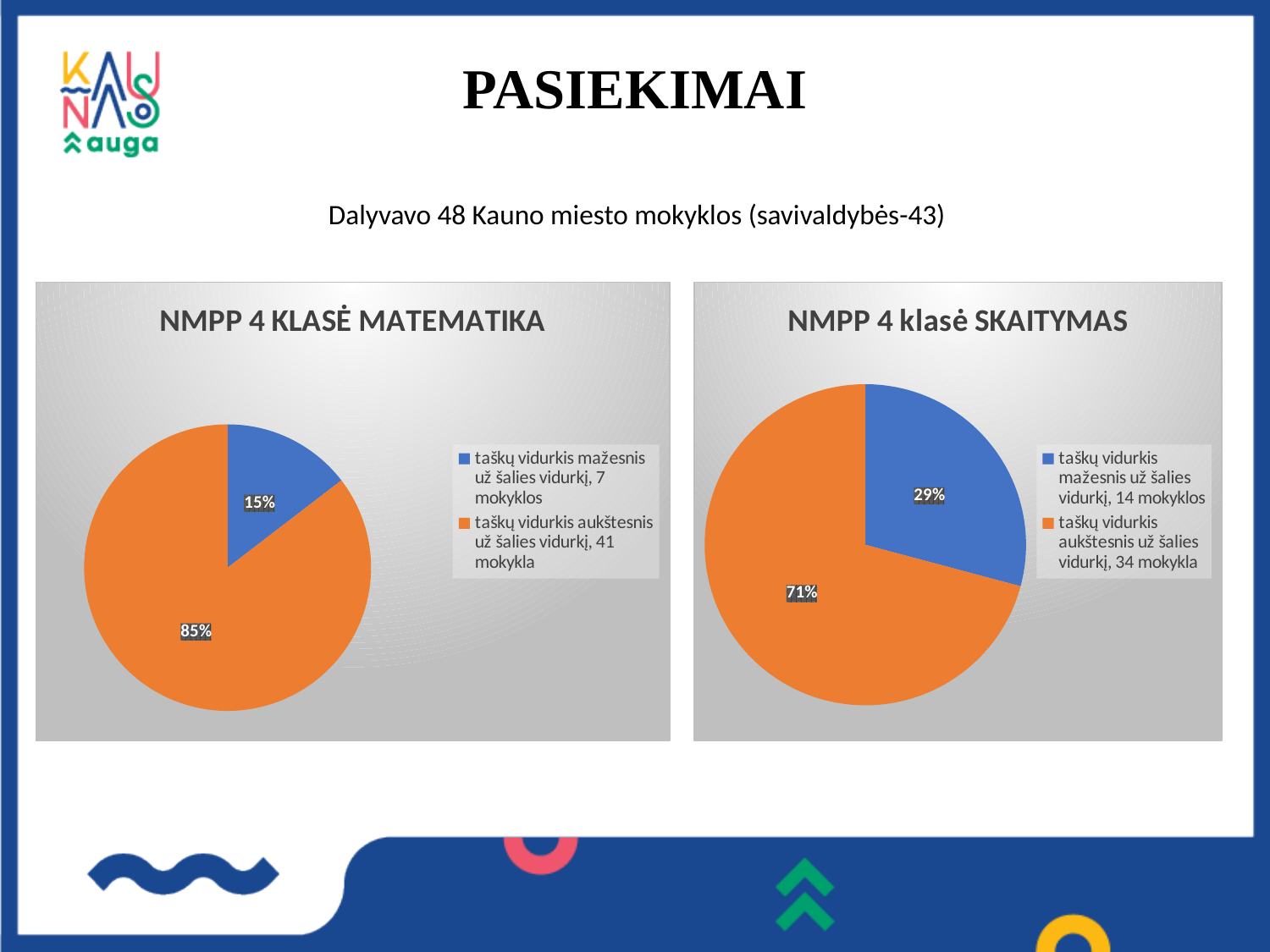
In the 'NMPP 4 KLASĖ MATEMATIKA' chart, what percentage of schools had an average score higher than the national average? 85% In the 'NMPP 4 klasė SKAITYMAS' chart, what is the difference in percentage points between the two slices? 42 In the 'NMPP 4 klasė SKAITYMAS' chart, how many schools does the legend say had an average score lower than the national average? 14 In the 'NMPP 4 klasė SKAITYMAS' chart, which slice is the largest? taškų vidurkis aukštesnis už šalies vidurkį, 34 mokykla In the 'NMPP 4 klasė SKAITYMAS' chart, what percentage of schools had an average score higher than the national average? 71% What type of chart is 'NMPP 4 KLASĖ MATEMATIKA'? Pie chart In the 'NMPP 4 KLASĖ MATEMATIKA' chart, which slice is the smallest? taškų vidurkis mažesnis už šalies vidurkį, 7 mokyklos In the 'NMPP 4 KLASĖ MATEMATIKA' chart, what percentage of schools had an average score lower than the national average? 15% In the 'NMPP 4 klasė SKAITYMAS' chart, what percentage of schools had an average score lower than the national average? 29% In the 'NMPP 4 klasė SKAITYMAS' chart, what colour is the slice for schools with an average score lower than the national average? Blue How many slices does the 'NMPP 4 KLASĖ MATEMATIKA' pie chart have? 2 In the 'NMPP 4 KLASĖ MATEMATIKA' chart, how many schools does the legend say had an average score higher than the national average? 41